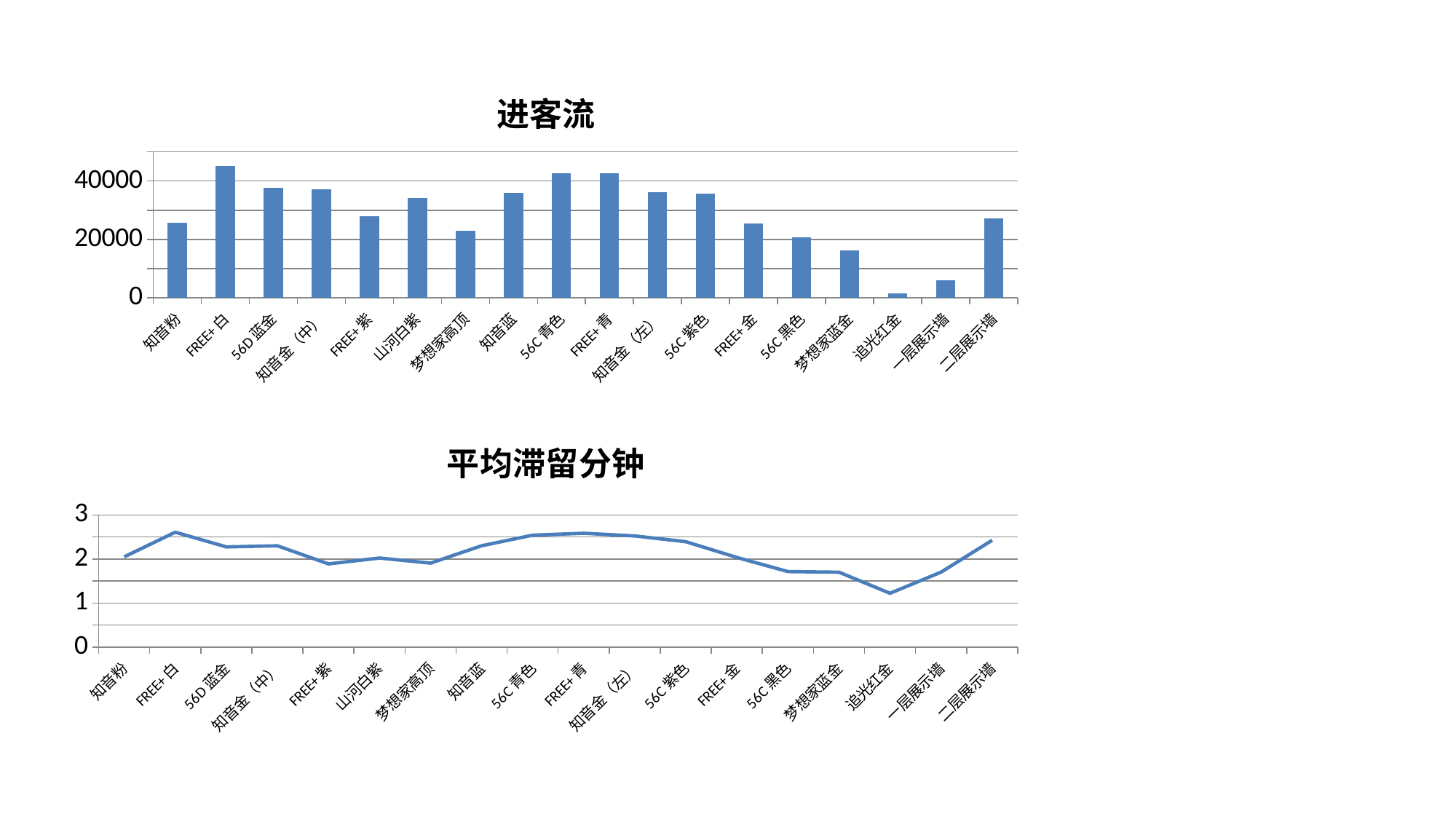
In the 进客流 chart, which category has the lowest value? 追光红金 In the 进客流 chart, is the value for FREE+ 白 greater or less than 40000? greater In the 平均滞留分钟 chart, is the value for FREE+ 白 greater or less than 2? greater In the 进客流 chart, which is larger, the value for FREE+ 白 or the value for 知音粉? FREE+ 白 In the 平均滞留分钟 chart, is the value for 56C 黑色 greater or less than 2? less In the 平均滞留分钟 chart, which category has the lowest value? 追光红金 What kind of chart is the chart titled 平均滞留分钟? line chart What kind of chart is the chart titled 进客流? bar chart In the 进客流 chart, how many categories are shown on the x axis? 18 In the 进客流 chart, which category has the highest value? FREE+ 白 In the 平均滞留分钟 chart, which is larger, the value for FREE+ 白 or the value for 追光红金? FREE+ 白